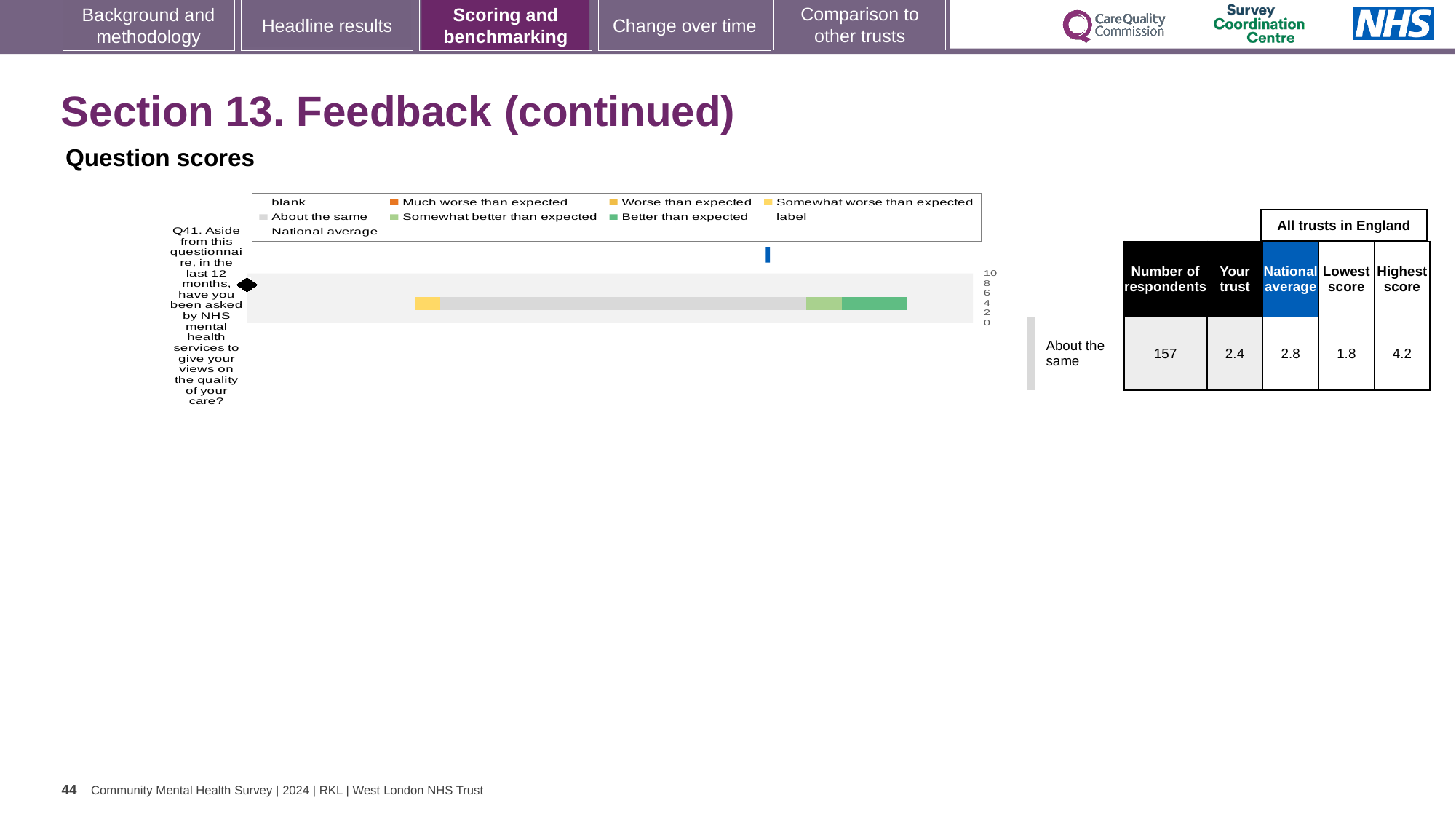
What colour represents 'Better than expected' in the legend? Green What is the difference between the national average and the 'Your trust' score for Q41? 0.4 What is the lowest score among all trusts in England for Q41? 1.8 How many respondents answered Q41? 157 What is the difference between the highest and lowest scores for Q41? 2.4 Which benchmark category is the trust's Q41 score placed in? About the same What is the highest score among all trusts in England for Q41? 4.2 What is the national average score for Q41? 2.8 How many questions are plotted on the chart? 1 What is the 'Your trust' score for Q41? 2.4 Which is larger for Q41, the 'Your trust' score or the national average? National average What kind of chart is used to show the Q41 question score? bar chart